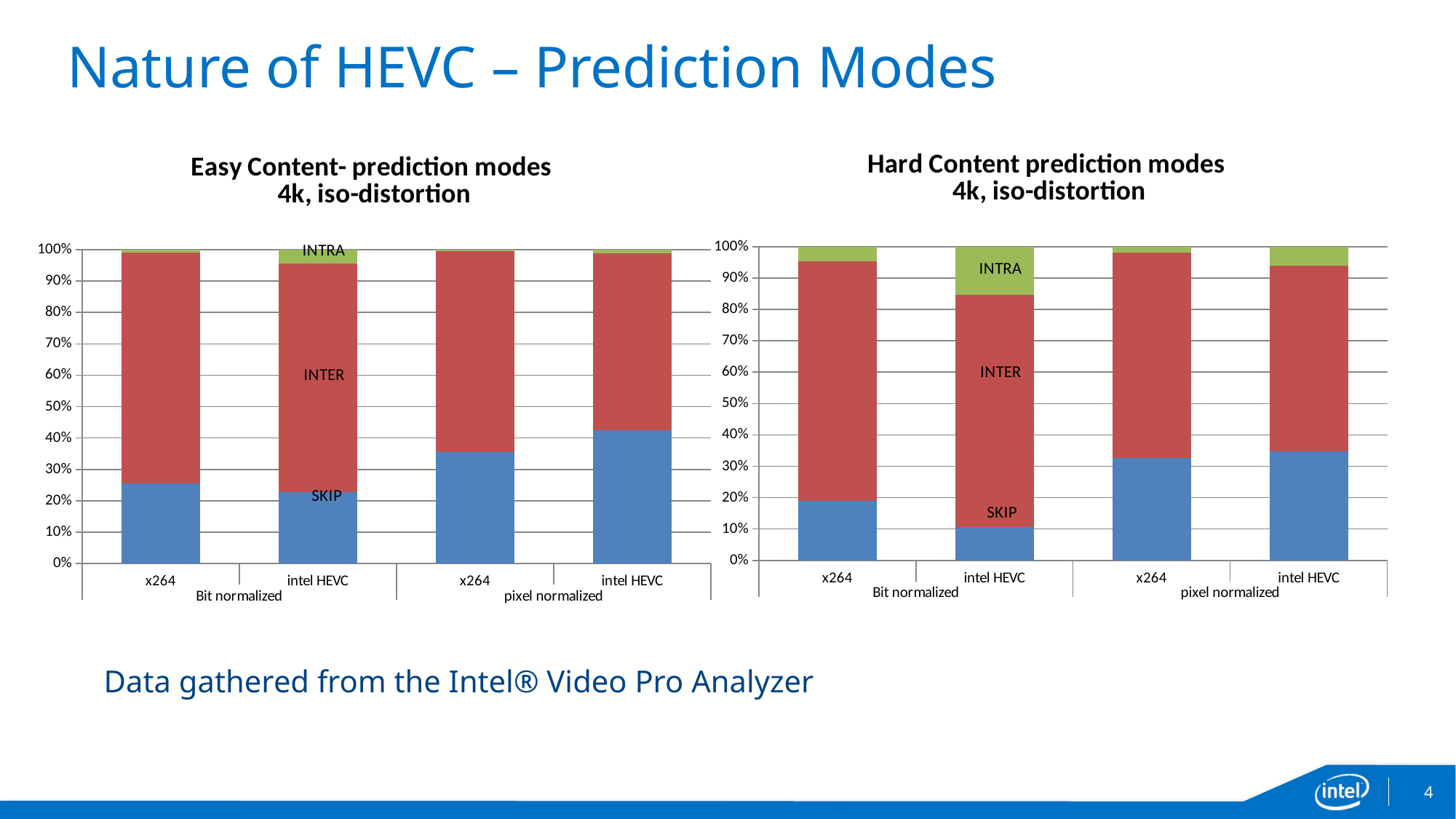
In the 'Hard Content prediction modes' chart, which bar has the smallest SKIP share? intel HEVC (Bit normalized) In the 'Hard Content prediction modes' chart, is the SKIP share for intel HEVC (Bit normalized) greater or less than 20%? less In the 'Easy Content- prediction modes' chart, which three prediction modes are labelled on the bars? SKIP, INTER, INTRA What is the title of the chart on the right of the slide? Hard Content prediction modes 4k, iso-distortion In the 'Hard Content prediction modes' chart, which has the larger SKIP share under Bit normalized: x264 or intel HEVC? x264 How many bars are plotted in the 'Hard Content prediction modes 4k, iso-distortion' chart? 4 In the 'Hard Content prediction modes' chart, is the INTRA share for intel HEVC (Bit normalized) greater or less than 10%? greater In the 'Hard Content prediction modes' chart, which bar has the largest INTRA share? intel HEVC (Bit normalized) In the 'Easy Content- prediction modes' chart, which bar has the largest SKIP share? intel HEVC (pixel normalized) What kind of chart is the 'Easy Content- prediction modes 4k, iso-distortion' chart? Stacked bar chart In the 'Easy Content- prediction modes' chart, is the SKIP share for x264 (Bit normalized) greater or less than 30%? less